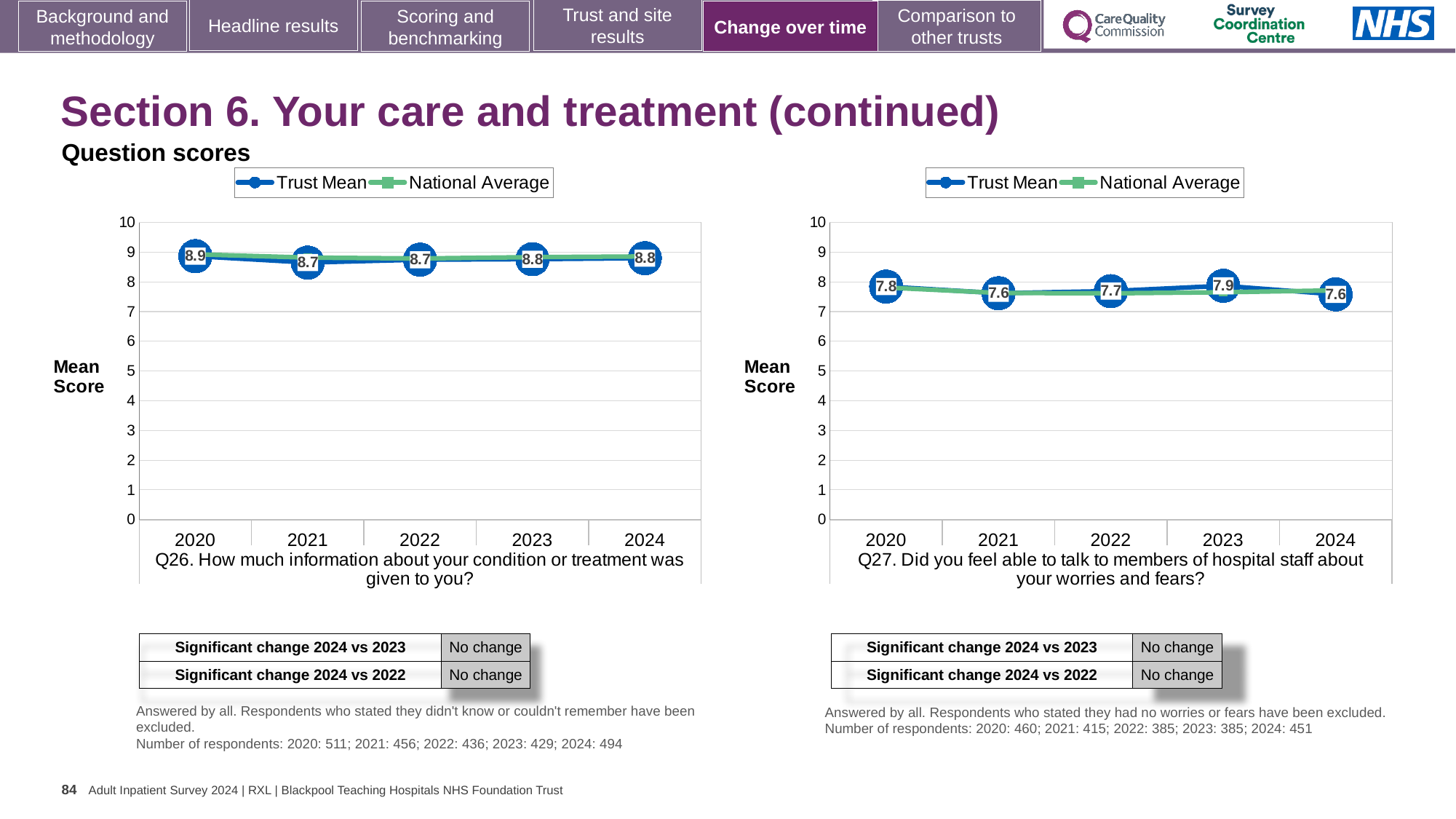
On the Q26 chart, which is larger, the Trust Mean score for 2020 or for 2021? 2020 What kind of chart is the Q26 chart? Line chart On the Q27 chart, is the National Average value for 2021 greater or less than 8? less On the Q26 chart, what is the Trust Mean score for 2024? 8.8 On the Q27 chart, what is the Trust Mean score for 2021? 7.6 On the Q27 chart, what is the Trust Mean score for 2023? 7.9 On the Q27 chart, which year has the highest Trust Mean score? 2023 How many series does the legend of the Q27 chart list? 2 How many years are plotted on the Q26 chart? 5 On the Q26 chart, what is the Trust Mean score for 2020? 8.9 On the Q26 chart, which year has the highest Trust Mean score? 2020 On the Q27 chart, what is the difference between the Trust Mean scores for 2023 and 2024? 0.3